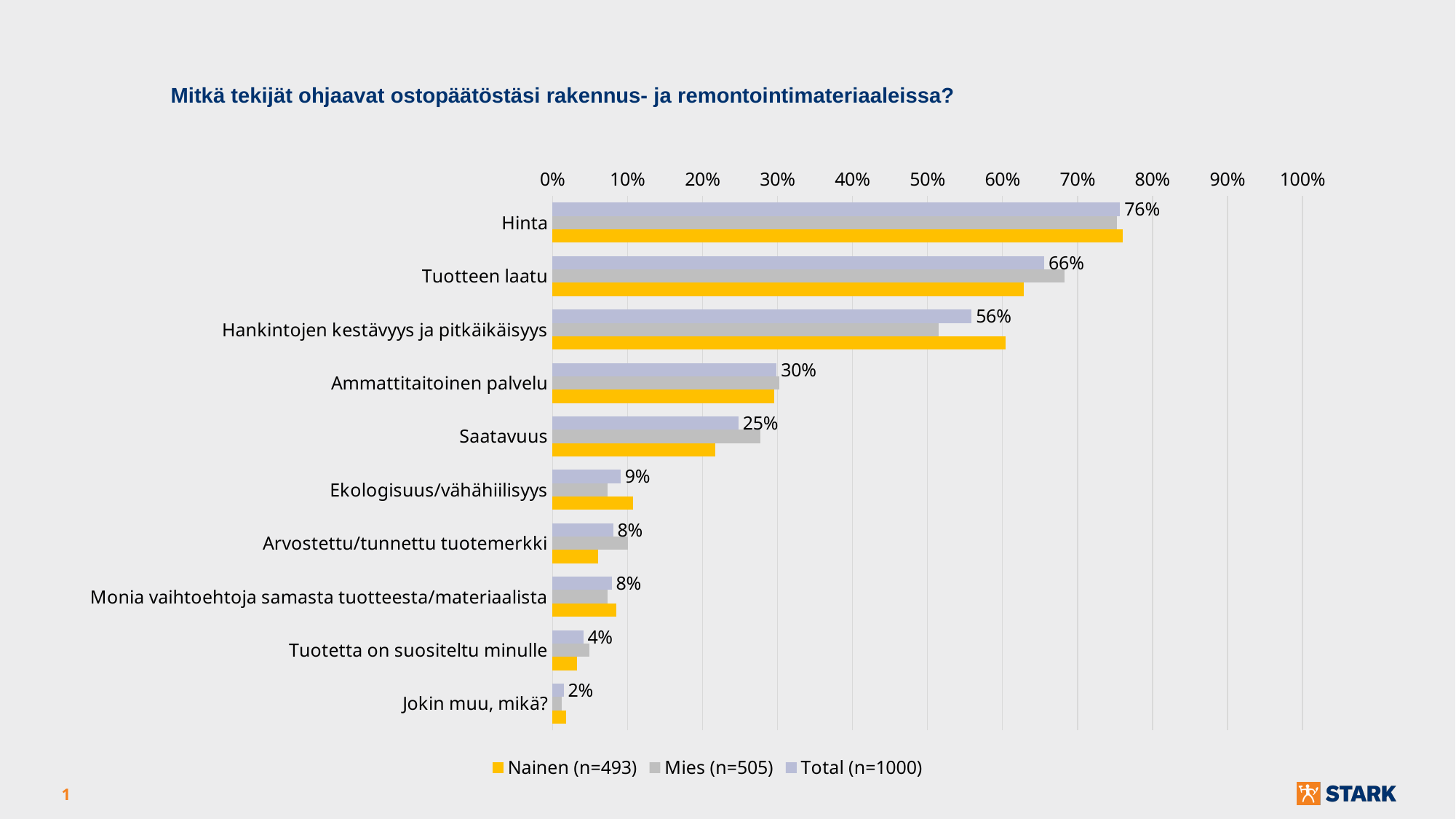
For Hankintojen kestävyys ja pitkäikäisyys, which is larger: the Nainen (n=493) value or the Mies (n=505) value? Nainen (n=493) What is the Total (n=1000) value for Saatavuus? 25% What is the Total (n=1000) value for Hinta? 76% What is the difference between the Total values for Hinta and Tuotteen laatu? 10% Is the Mies (n=505) value for Tuotteen laatu greater or less than 60%? greater What is the Total (n=1000) value for Tuotteen laatu? 66% How many series does the legend list? 3 What kind of chart is shown on the slide? Bar chart Which category has the lowest Total (n=1000) value? Jokin muu, mikä? How many categories are shown on the chart? 10 Which category has the highest Total (n=1000) value? Hinta Which series is shown in yellow? Nainen (n=493)